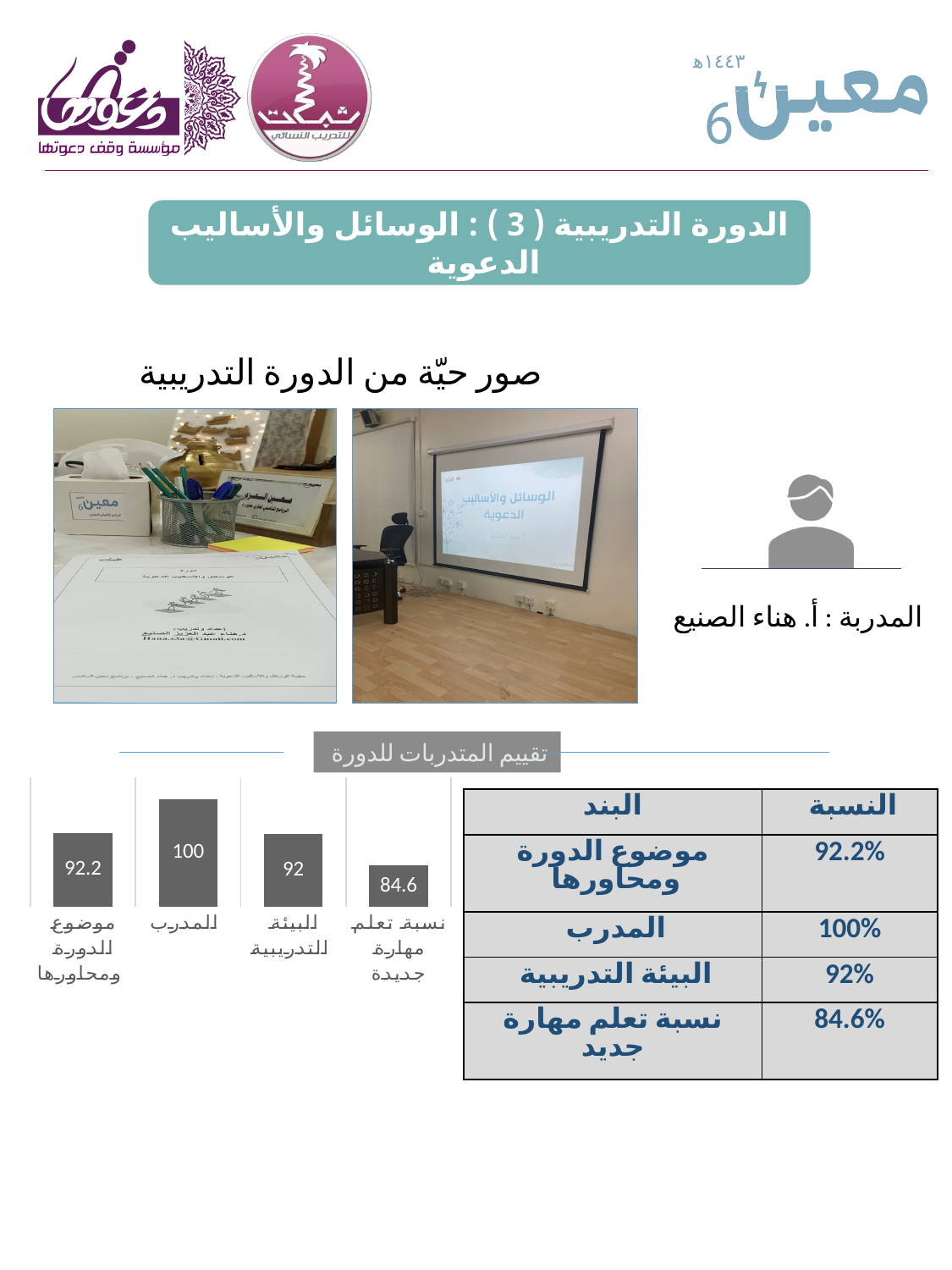
Which category has the highest bar in the chart? المدرب How many bars (categories) does the chart show? 4 What is the value of the bar for البيئة التدريبية? 92 What is the difference between the values for موضوع الدورة ومحاورها and البيئة التدريبية? 0.2 What is the value of the bar for نسبة تعلم مهارة جديدة? 84.6 Which is larger, the value for المدرب or the value for البيئة التدريبية? المدرب What is the value of the bar for موضوع الدورة ومحاورها? 92.2 What is the title shown above the chart and table? تقييم المتدربات للدورة Which category has the lowest bar in the chart? نسبة تعلم مهارة جديدة What is the difference between the values for المدرب and نسبة تعلم مهارة جديدة? 15.4 What is the value of the bar for المدرب? 100 What type of chart is shown at the bottom of the slide? Bar chart